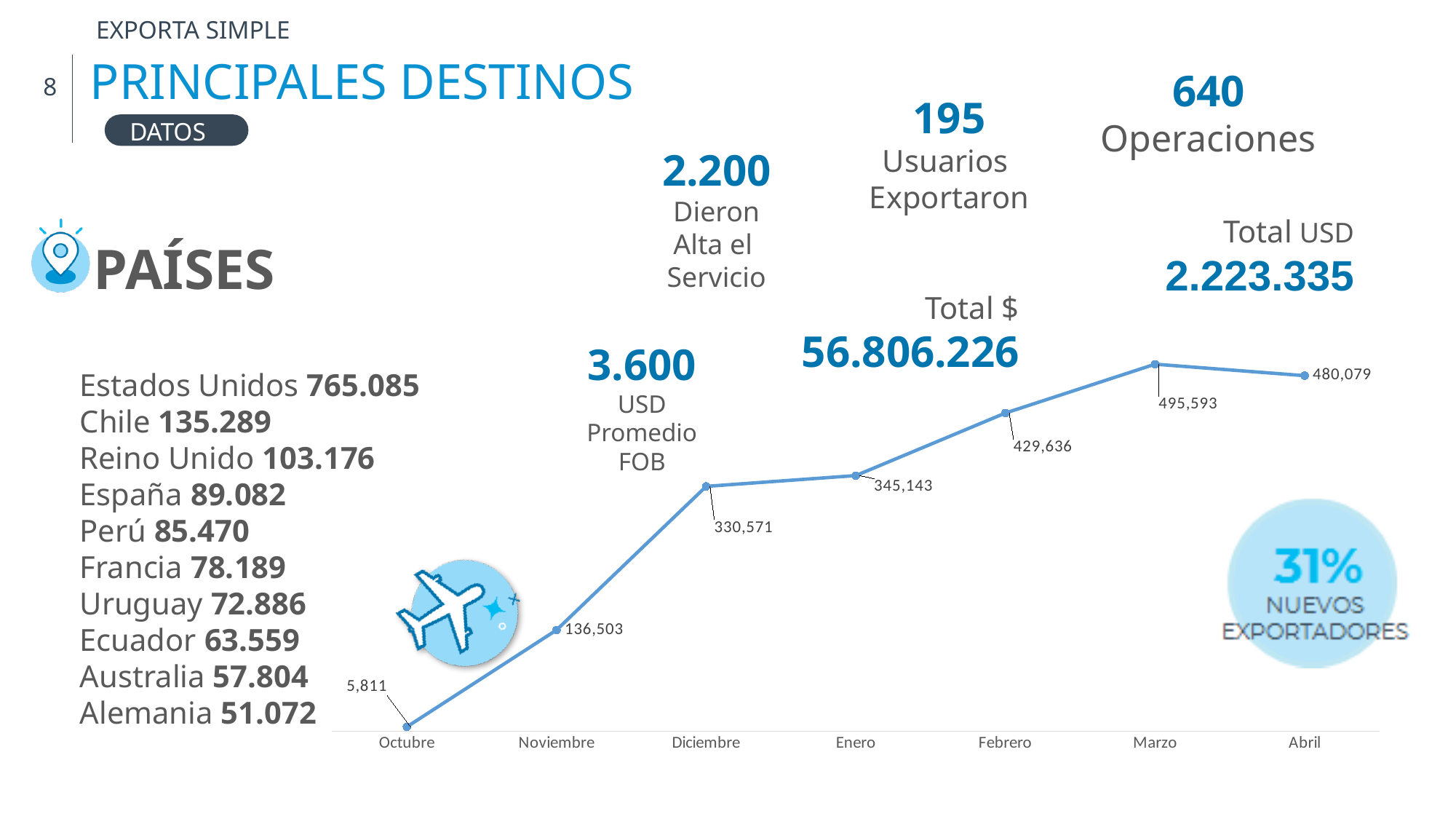
What kind of chart is shown on the slide? line chart What is the value for Abril in the line chart? 480,079 Do the values in the line chart generally rise or fall from Octubre to Marzo? rise Which is larger in the line chart, the value for Enero or the value for Febrero? Febrero Which month has the highest value in the line chart? Marzo What is the difference between the values for Noviembre and Octubre in the line chart? 130,692 What is the value for Marzo in the line chart? 495,593 What is the difference between the values for Marzo and Abril in the line chart? 15,514 Which month has the lowest value in the line chart? Octubre How many months are plotted on the x axis of the line chart? 7 What is the value for Diciembre in the line chart? 330,571 What is the value for Octubre in the line chart? 5,811